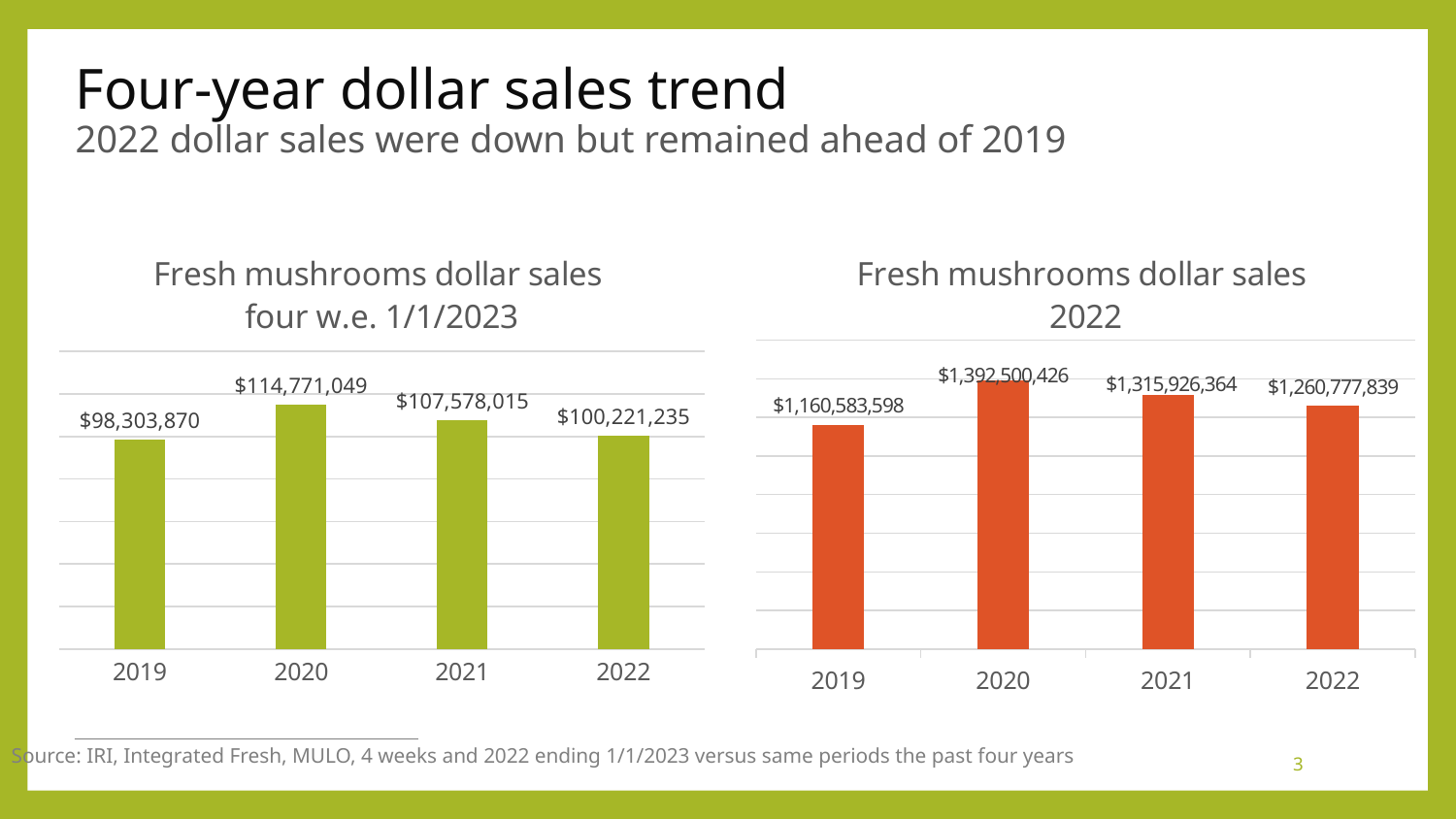
In the 'Fresh mushrooms dollar sales four w.e. 1/1/2023' chart, which year has the lowest value? 2019 In the 'Fresh mushrooms dollar sales 2022' chart, which year has the highest value? 2020 In the 'Fresh mushrooms dollar sales 2022' chart, what is the value for 2019? $1,160,583,598 In the 'Fresh mushrooms dollar sales 2022' chart, which is larger, the value for 2021 or the value for 2022? 2021 In the 'Fresh mushrooms dollar sales four w.e. 1/1/2023' chart, which year has the highest value? 2020 In the 'Fresh mushrooms dollar sales four w.e. 1/1/2023' chart, what is the value for 2021? $107,578,015 In the 'Fresh mushrooms dollar sales 2022' chart, what is the difference between the 2020 and 2022 values? $131,722,587 In the 'Fresh mushrooms dollar sales four w.e. 1/1/2023' chart, what is the difference between the 2020 and 2019 values? $16,467,179 In the 'Fresh mushrooms dollar sales 2022' chart, which year has the lowest value? 2019 What kind of chart is the 'Fresh mushrooms dollar sales 2022' chart? Bar chart How many years are shown in the 'Fresh mushrooms dollar sales four w.e. 1/1/2023' chart? 4 In the 'Fresh mushrooms dollar sales 2022' chart, do the values rise or fall from 2020 to 2022? Fall